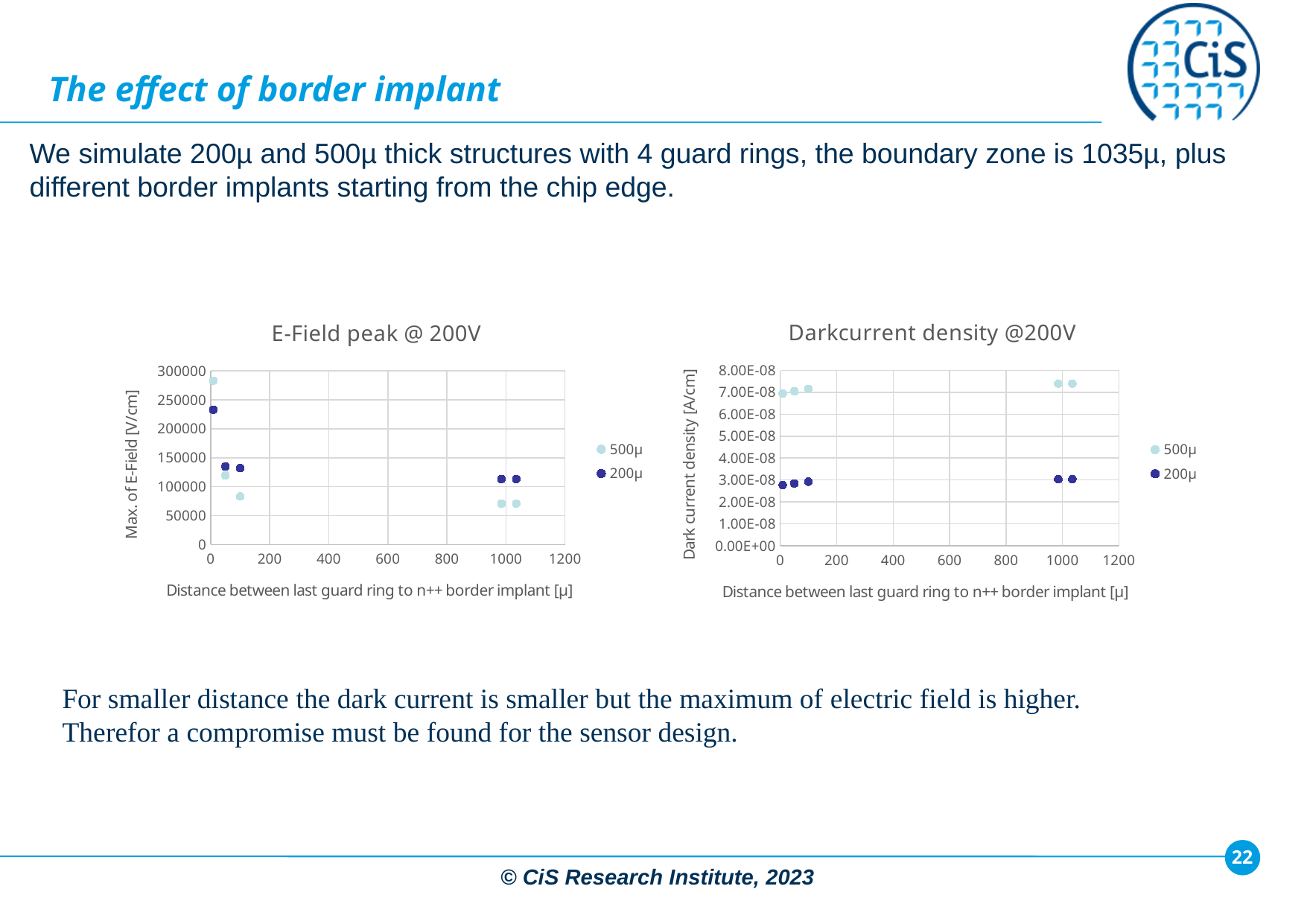
In the 'E-Field peak @ 200V' chart, which series has the higher value near a distance of 1000, 500µ or 200µ? 200µ What is the y-axis label of the 'Darkcurrent density @200V' chart? Dark current density [A/cm] In the 'E-Field peak @ 200V' chart, are the 500µ values near a distance of 1000 greater or less than 100000? less In the 'Darkcurrent density @200V' chart, are the 500µ values greater or less than 6.00E-08? greater In the 'Darkcurrent density @200V' chart, which series has the higher dark current density, 500µ or 200µ? 500µ What are the two legend entries on the 'E-Field peak @ 200V' chart? 500µ and 200µ How many series does the legend of the 'Darkcurrent density @200V' chart list? 2 In the 'E-Field peak @ 200V' chart, is the 200µ value at distance 0 greater or less than 200000? greater In the 'E-Field peak @ 200V' chart, do the 500µ values rise or fall as the distance increases? fall What kind of chart is the 'E-Field peak @ 200V' chart? scatter chart